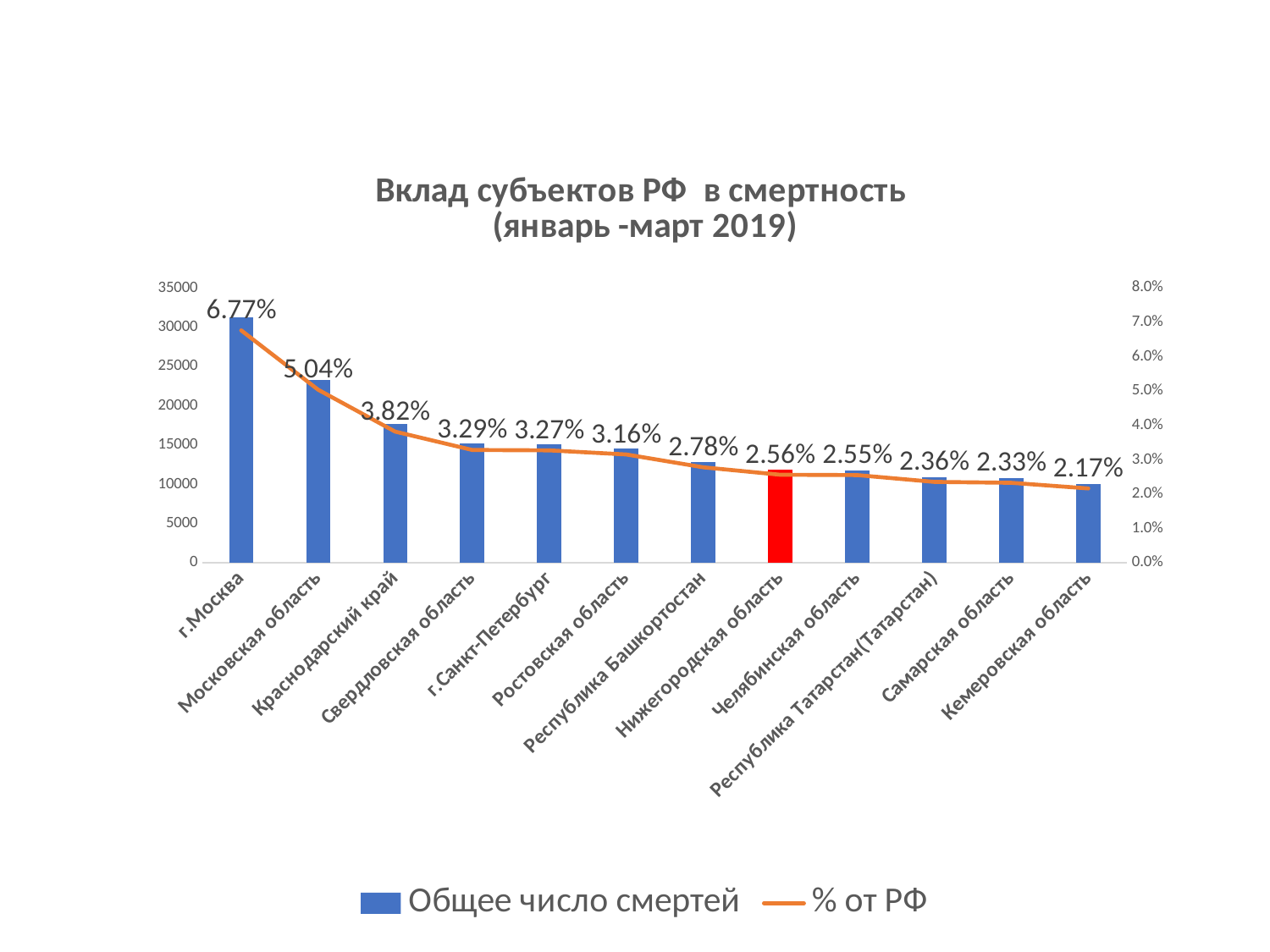
What kind of chart is this? Combined bar and line chart Which region's bar is coloured red? Нижегородская область What is the % от РФ value for Республика Башкортостан? 2.78% Is the Общее число смертей value for Московская область greater or less than 25000? less What is the % от РФ value for г.Москва? 6.77% Which region has the lowest % от РФ value? Кемеровская область What is the difference between the % от РФ values for г.Москва and Московская область? 1.73% How many series does the legend list? 2 Which region has the highest % от РФ value? г.Москва What is the % от РФ value for Кемеровская область? 2.17% How many regions are shown on the x axis? 12 Which has a larger % от РФ value, Краснодарский край or Свердловская область? Краснодарский край